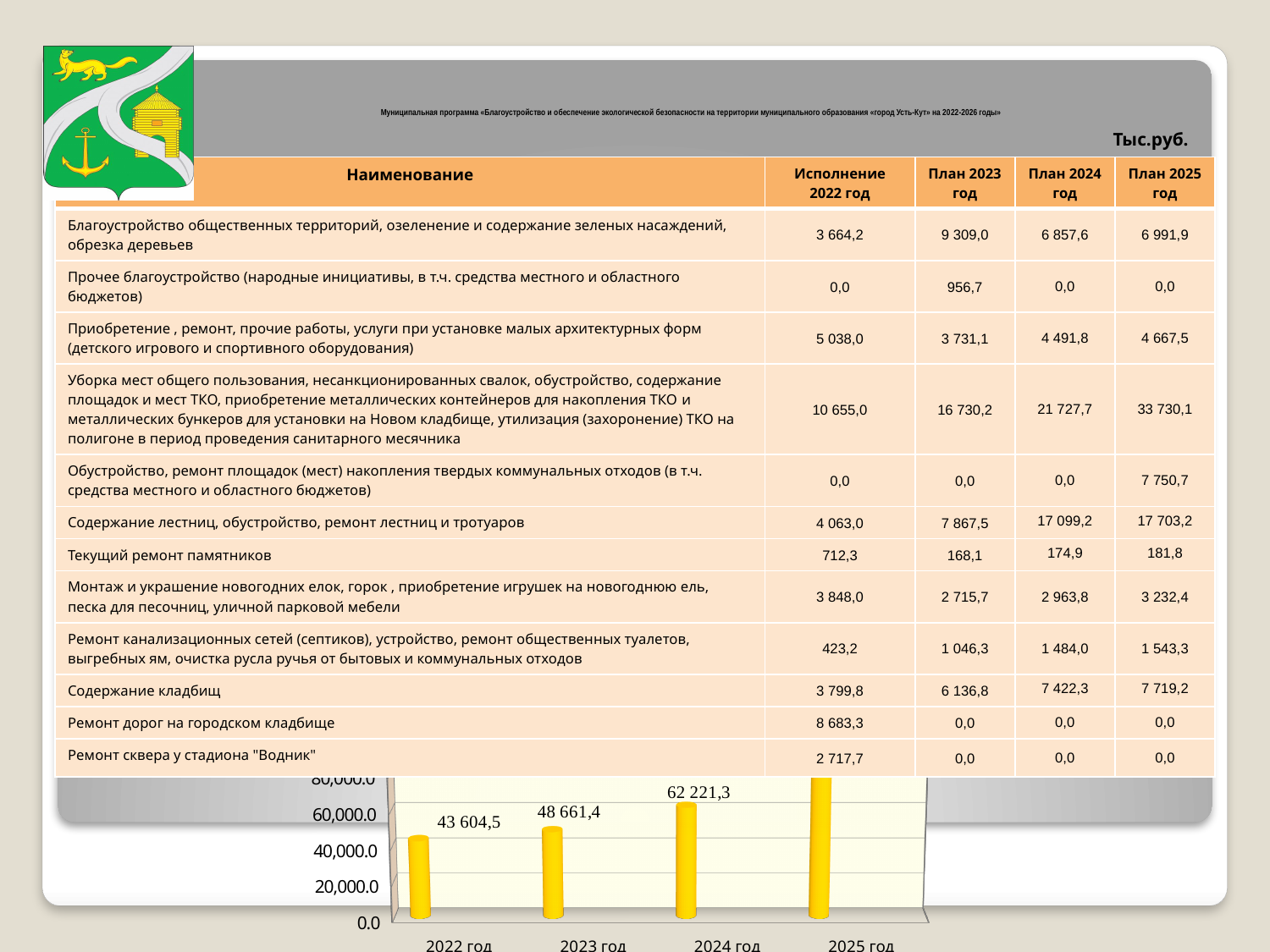
Which year has the tallest bar in the chart? 2025 год What is the value for 2022 год in the bar chart at the bottom of the slide? 43 604,5 How many bars are shown in the chart? 4 Do the values in the bar chart rise or fall from 2022 год to 2025 год? rise What is the difference between the values for 2023 год and 2022 год in the bar chart? 5 056,9 What is the value for 2024 год in the bar chart? 62 221,3 Which year has the shortest bar in the chart? 2022 год Is the value for 2025 год in the bar chart greater or less than 60,000.0? greater What is the value for 2023 год in the bar chart? 48 661,4 What kind of chart is shown at the bottom of the slide? bar chart What is the difference between the values for 2024 год and 2023 год in the bar chart? 13 559,9 In the bar chart, which is larger: the value for 2022 год or the value for 2023 год? 2023 год